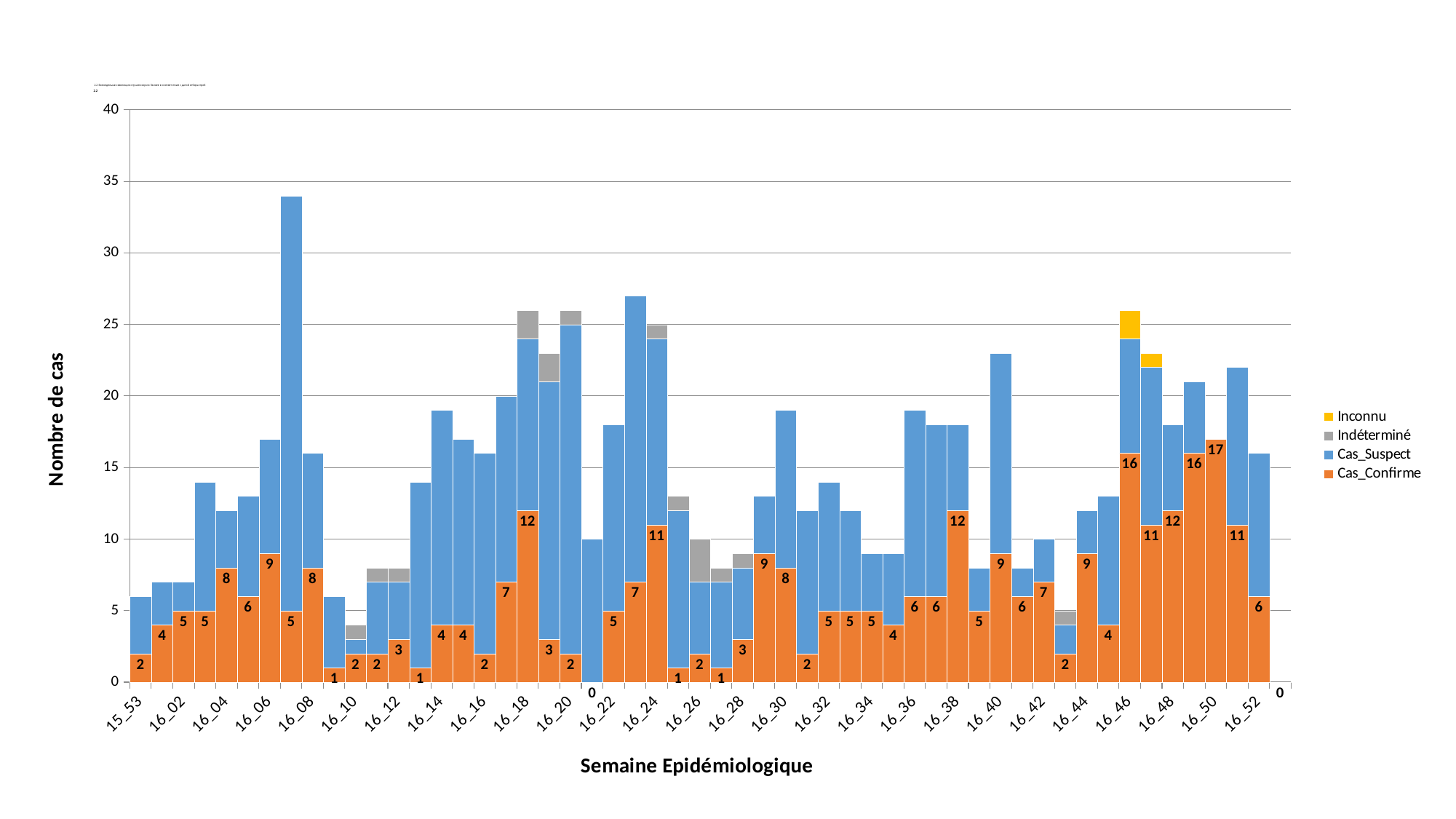
How many Cas_Confirme are shown for week 16_18? 12 Which labelled week has the highest number of Cas_Confirme? 16_50 How many Cas_Confirme are shown for week 15_53? 2 What is the difference in Cas_Confirme between week 16_50 and week 16_52? 11 Is the total number of cases for week 16_40 greater or less than 20? greater What kind of chart is shown on the slide? stacked bar chart Which week has more Cas_Confirme, 16_18 or 16_04? 16_18 How many series does the legend list? 4 How many Cas_Confirme are shown for week 16_46? 16 What is the title of the x axis? Semaine Epidémiologique How many Cas_Confirme are shown for week 16_50? 17 What are the four series listed in the legend? Inconnu, Indéterminé, Cas_Suspect, Cas_Confirme